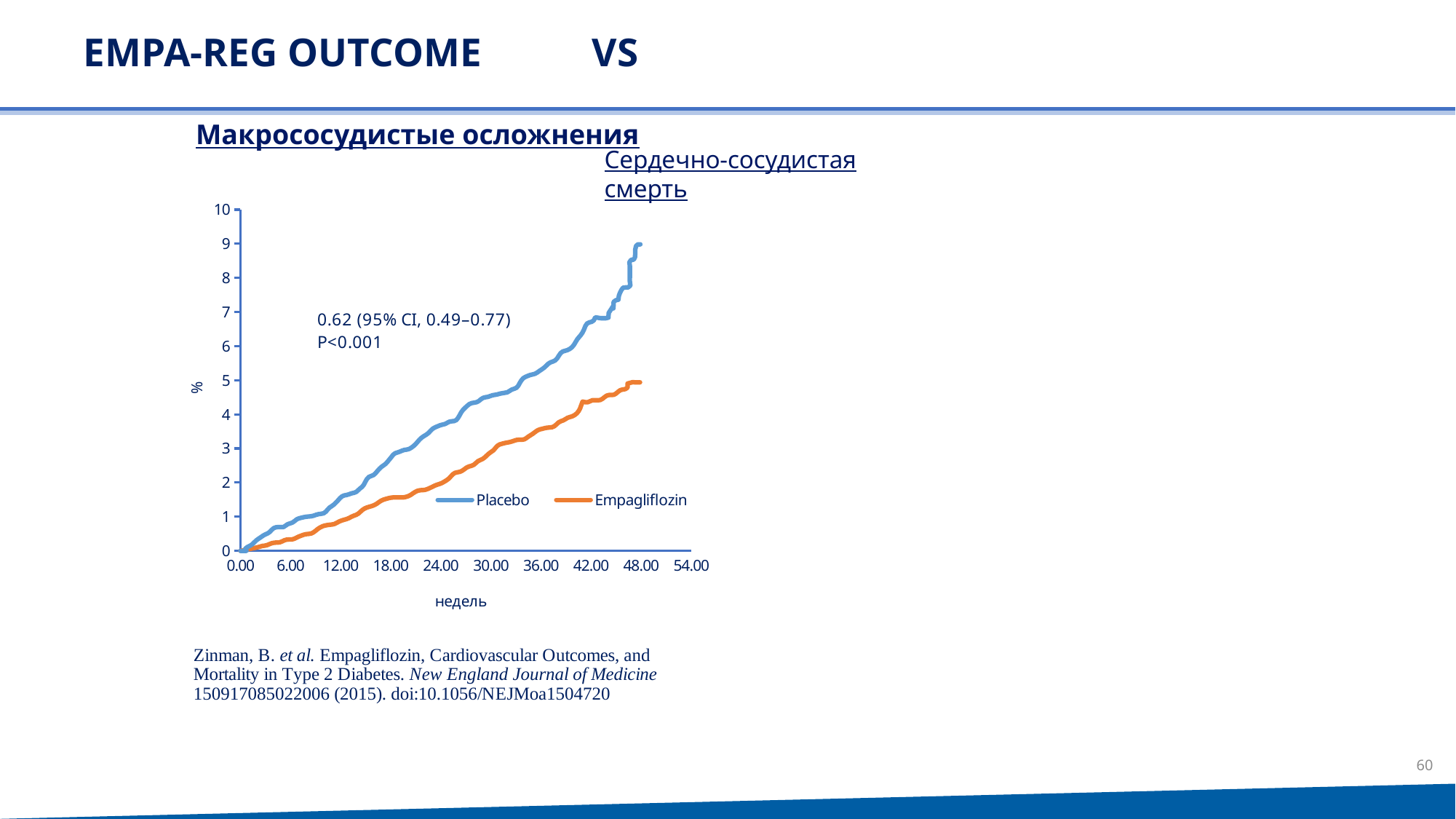
Do the values for Empagliflozin rise or fall along the x axis? rise What colour is the Placebo line in the chart? blue Is the value for Placebo at 24 weeks greater or less than 3? greater Is the value for Empagliflozin at 48 weeks greater or less than 6? less What kind of chart is shown on the slide? line chart Is the value for Empagliflozin at 24 weeks greater or less than 3? less Which series reaches the highest value on the chart? Placebo At 48 weeks, which series has the higher value, Placebo or Empagliflozin? Placebo Do the values for Placebo rise or fall as the weeks increase along the x axis? rise How many series does the chart legend list? 2 Which two series are listed in the chart legend? Placebo and Empagliflozin